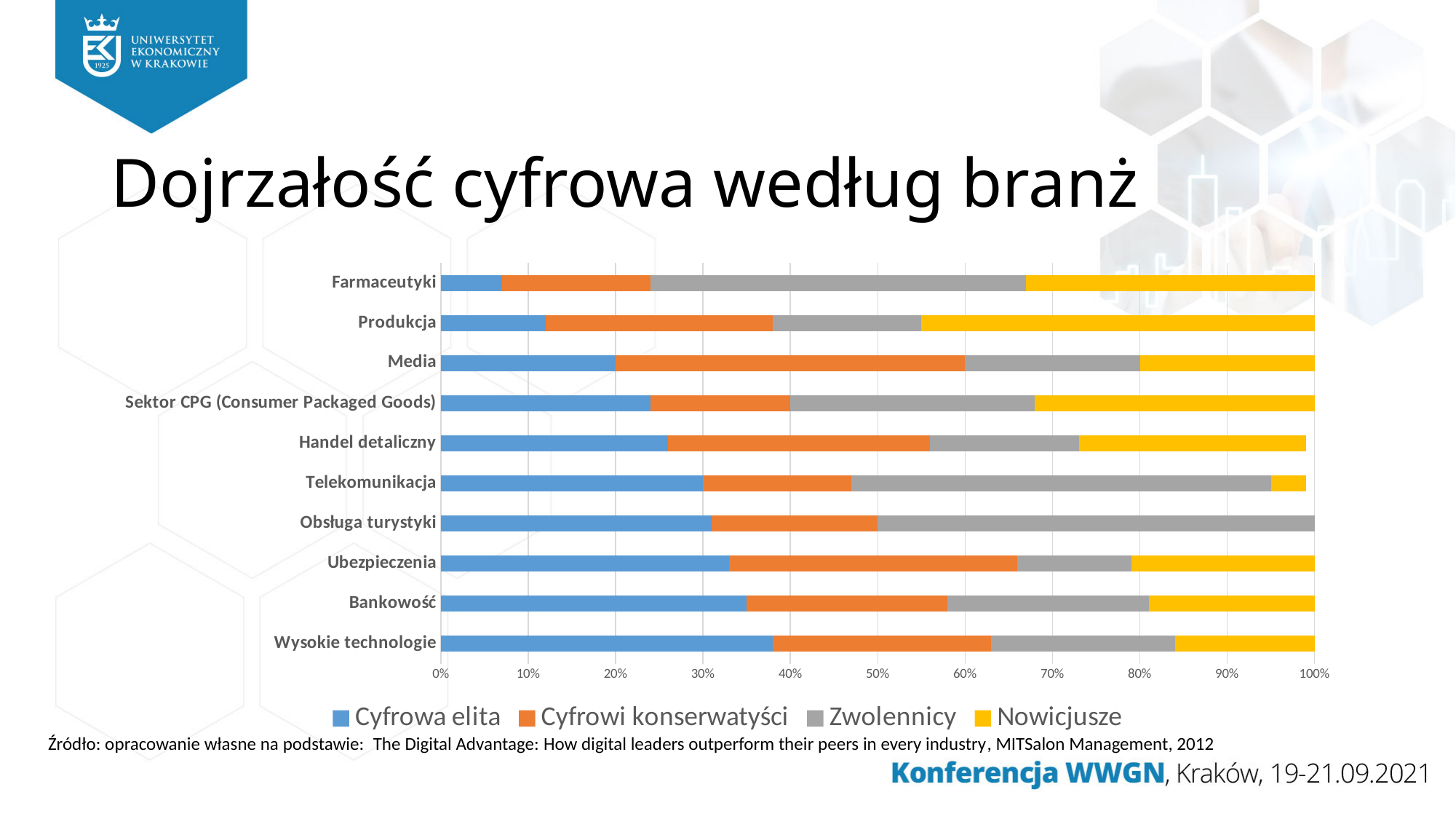
Which category has the smallest Nowicjusze share (no visible yellow segment)? Obsługa turystyki How many industry categories are plotted on the chart? 10 Is the Cyfrowa elita value for Media greater or less than 30%? less What is the title of the slide containing the chart? Dojrzałość cyfrowa według branż Which category has the smallest Cyfrowa elita share? Farmaceutyki How many series does the chart legend list? 4 Is the Cyfrowa elita value for Wysokie technologie greater or less than 30%? greater What are the four series named in the chart legend? Cyfrowa elita, Cyfrowi konserwatyści, Zwolennicy, Nowicjusze Which has the larger Cyfrowa elita share, Wysokie technologie or Farmaceutyki? Wysokie technologie Is the Cyfrowa elita value for Farmaceutyki greater or less than 10%? less Which category has the largest Cyfrowa elita share? Wysokie technologie What kind of chart is shown on the slide? bar chart